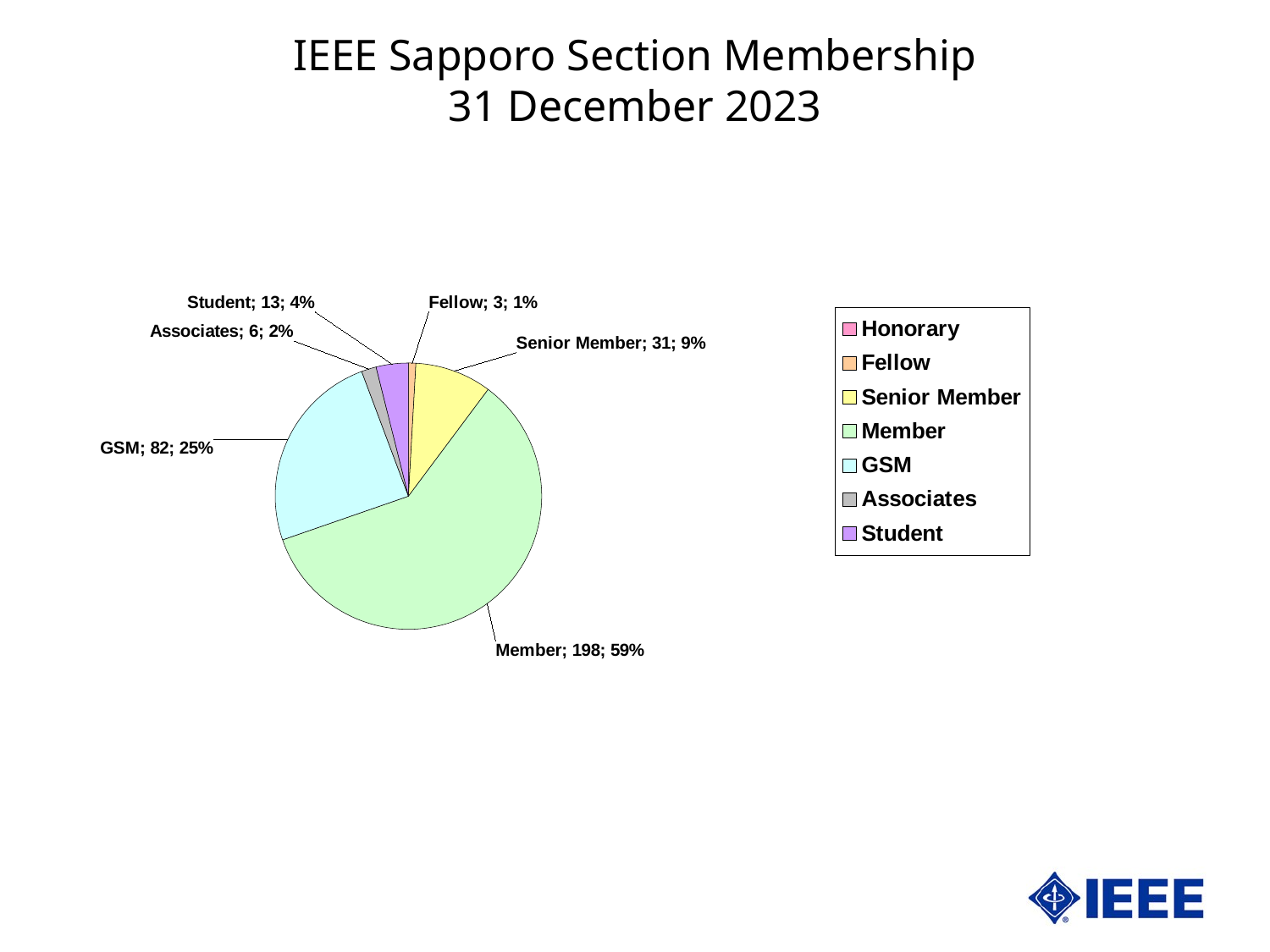
What share of the pie does the GSM slice represent? 25% What type of chart is shown on the slide? pie chart How many members are in the Senior Member category? 31 What colour is the Member slice in the pie chart? light green Which labelled category has the smallest slice of the pie? Fellow How many members are in the Member category? 198 Which category has the largest slice of the pie? Member What is the difference between the Senior Member count and the Fellow count? 28 What share of the pie does the Student slice represent? 4% How many entries does the legend list? 7 What is the difference between the number of Members and the number of GSM members? 116 Which is larger, the Associates count or the Student count? Student